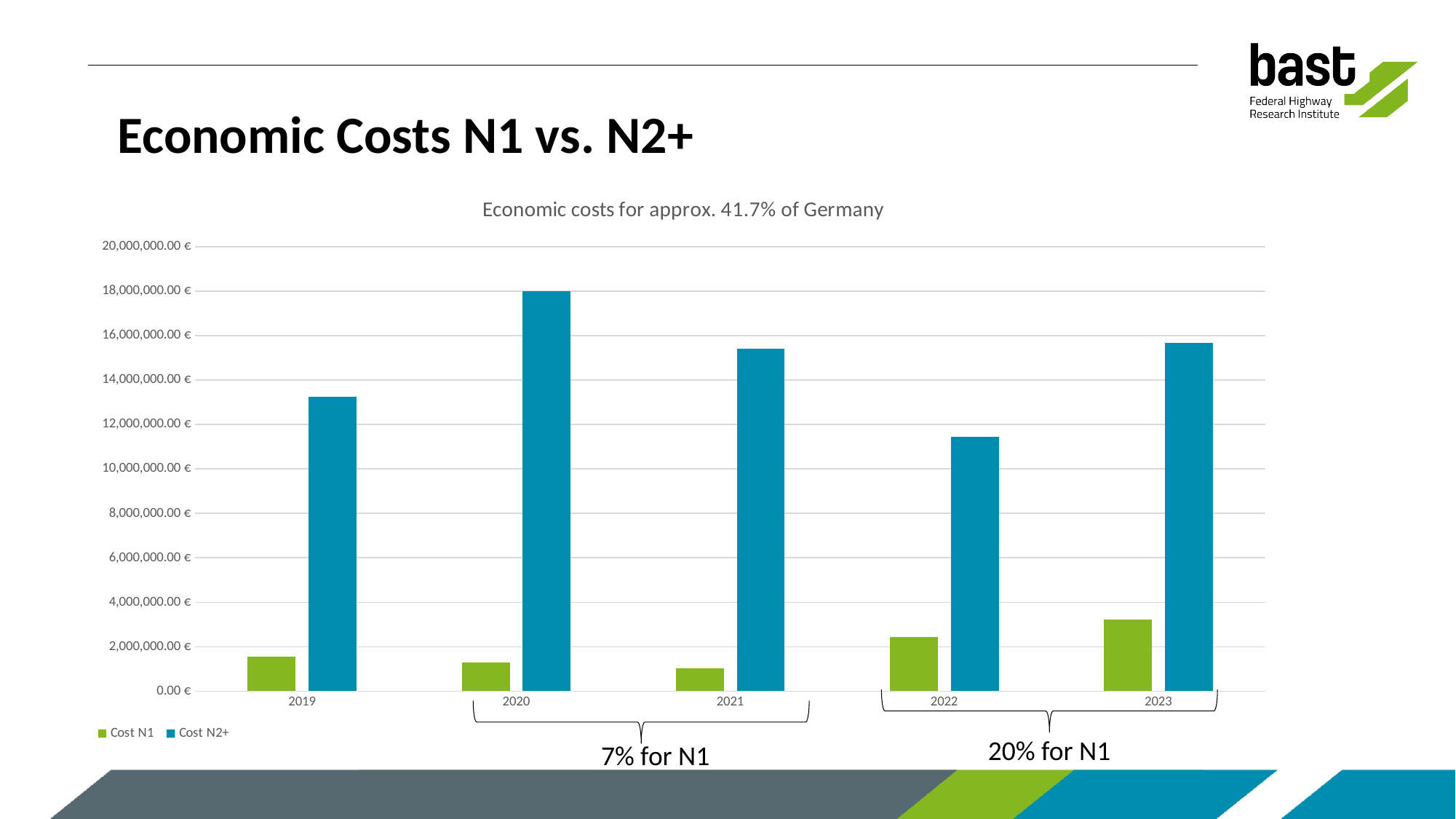
How many series does the legend list? 2 Does Cost N1 rise or fall from 2021 to 2023? rise Is the Cost N1 value for 2023 greater or less than 2,000,000.00 €? greater How many years are shown on the x axis? 5 What kind of chart is shown on the slide? bar chart In which year is Cost N2+ lowest? 2022 Is the Cost N2+ value for 2020 greater or less than 16,000,000.00 €? greater Is the Cost N2+ value for 2022 greater or less than 12,000,000.00 €? less Which year has the larger Cost N2+ value, 2019 or 2021? 2021 In which year is Cost N1 highest? 2023 In which year is Cost N2+ highest? 2020 What is the title of the chart? Economic costs for approx. 41.7% of Germany